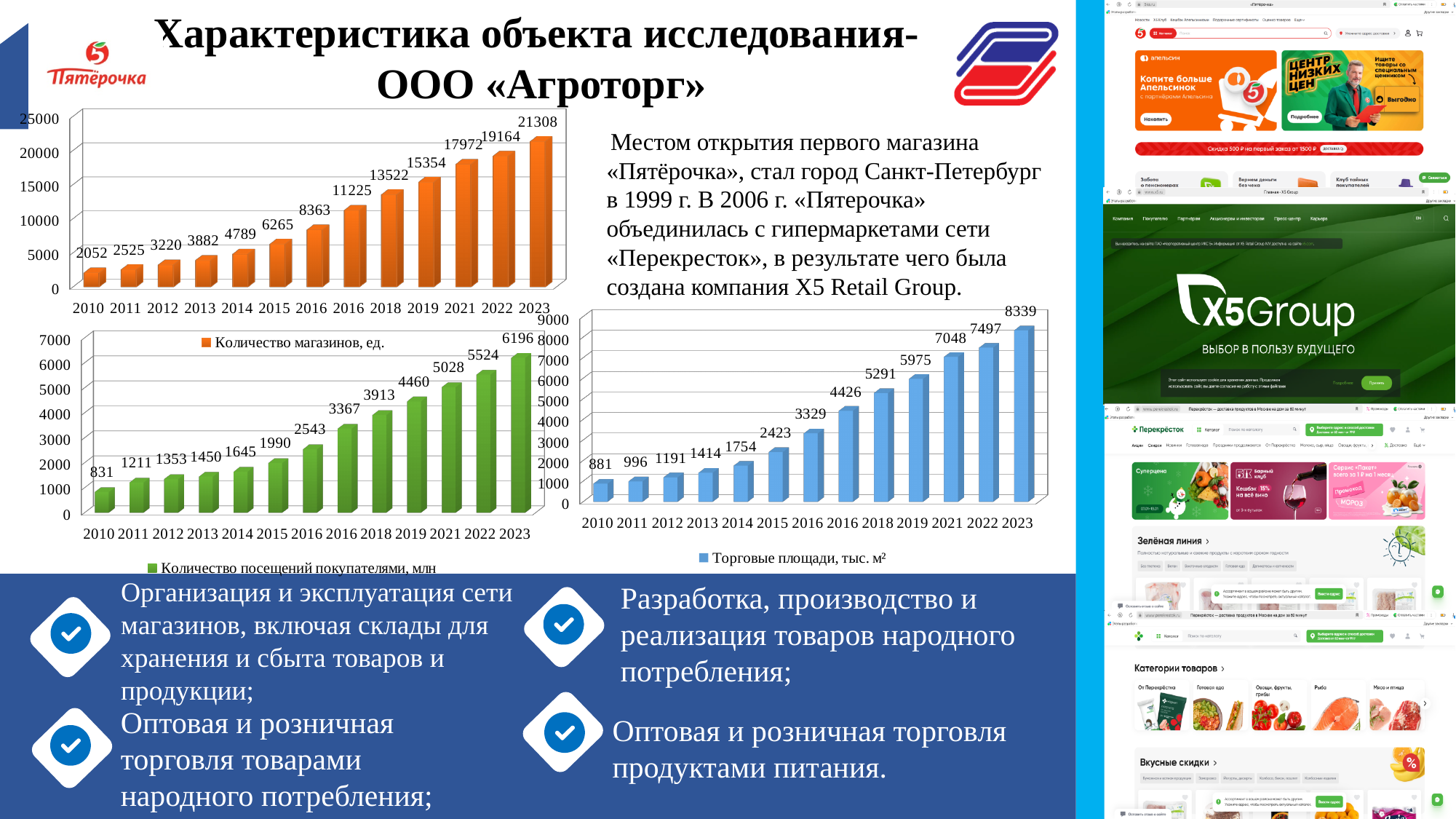
In the chart 'Количество магазинов, ед.', what is the value for 2023? 21308 In the chart 'Количество магазинов, ед.', what is the difference between the values for 2023 and 2022? 2144 In the chart 'Торговые площади, тыс. м²', which year has the highest value? 2023 What type of chart is the chart 'Количество посещений покупателями, млн'? Bar chart In the chart 'Количество магазинов, ед.', do the values rise or fall from 2010 to 2023? Rise In the chart 'Торговые площади, тыс. м²', what is the value for 2022? 7497 In the chart 'Торговые площади, тыс. м²', what is the difference between the values for 2015 and 2014? 669 In the chart 'Количество посещений покупателями, млн', what is the value for 2019? 4460 In the chart 'Количество посещений покупателями, млн', which year has the lowest value? 2010 How many bars are plotted in the chart 'Торговые площади, тыс. м²'? 13 In the chart 'Количество магазинов, ед.', what is the value for 2010? 2052 In the chart 'Количество посещений покупателями, млн', which is larger, the value for 2018 or the value for 2015? 2018